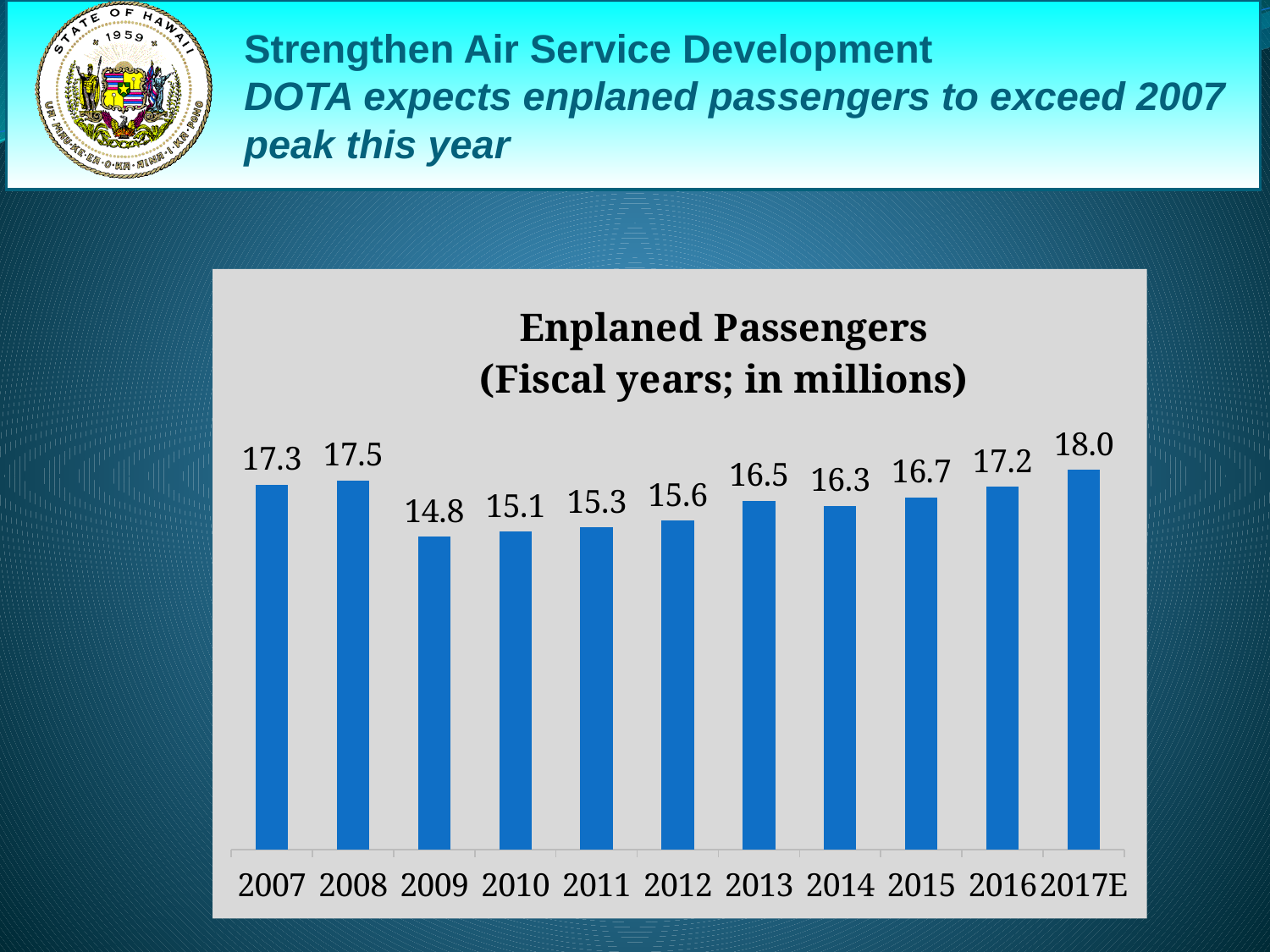
How many years are shown on the x axis of the Enplaned Passengers chart? 11 What is the value for 2009 in the Enplaned Passengers chart? 14.8 Which is larger in the Enplaned Passengers chart, the value for 2013 or the value for 2014? 2013 What kind of chart is the Enplaned Passengers chart? Bar chart What is the difference between the values for 2008 and 2009 in the Enplaned Passengers chart? 2.7 Do the values in the Enplaned Passengers chart rise or fall from 2009 to 2013? Rise What unit does the subtitle of the Enplaned Passengers chart say the values are in? Millions Which year has the highest value in the Enplaned Passengers chart? 2017E What is the value for 2013 in the Enplaned Passengers chart? 16.5 Which year has the lowest value in the Enplaned Passengers chart? 2009 What is the difference between the values for 2017E and 2007 in the Enplaned Passengers chart? 0.7 What is the value for 2017E in the Enplaned Passengers chart? 18.0